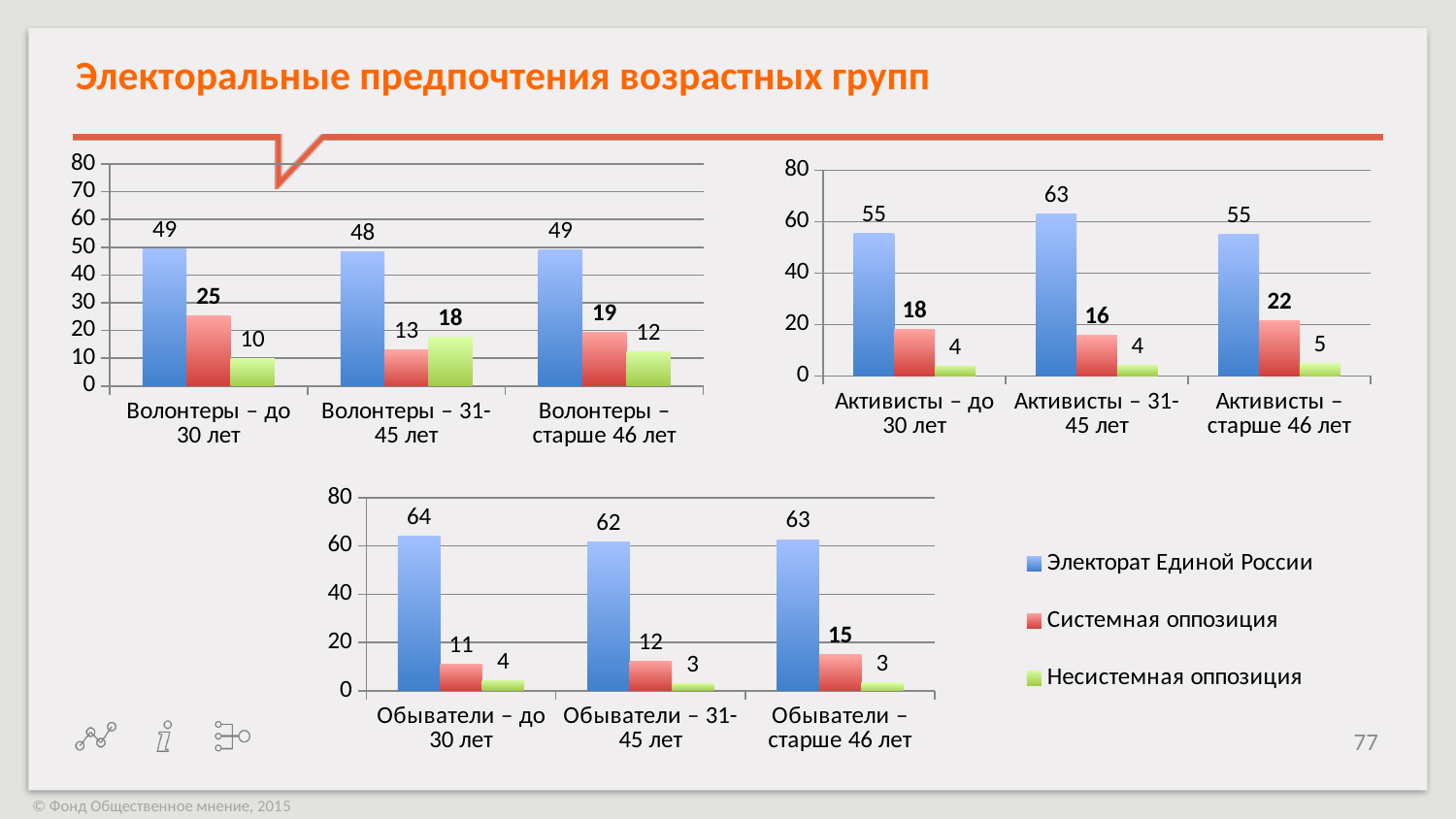
In the top-right chart (Активисты), what is the value for Несистемная оппозиция among Активисты – старше 46 лет? 5 In the bottom chart (Обыватели), which age group has the lowest value for Электорат Единой России? Обыватели – 31-45 лет In the top-right chart (Активисты), which age group has the highest value for Электорат Единой России? Активисты – 31-45 лет How many age-group categories are shown in the bottom chart (Обыватели)? 3 In the top-left chart (Волонтеры), which is larger: Системная оппозиция for Волонтеры – до 30 лет or Несистемная оппозиция for Волонтеры – 31-45 лет? Системная оппозиция for Волонтеры – до 30 лет In the bottom chart (Обыватели), what is the difference between the Электорат Единой России value for Обыватели – до 30 лет and the Системная оппозиция value for the same group? 53 In the top-right chart (Активисты), is the value for Электорат Единой России among Активисты – 31-45 лет greater or less than 60? greater Which series is shown in green in the legend? Несистемная оппозиция In the top-left chart (Волонтеры), what is the value for Электорат Единой России among Волонтеры – до 30 лет? 49 How many series does the legend list? 3 What type of chart is the top-right chart (Активисты)? bar chart In the top-left chart (Волонтеры), what is the value for Системная оппозиция among Волонтеры – 31-45 лет? 13